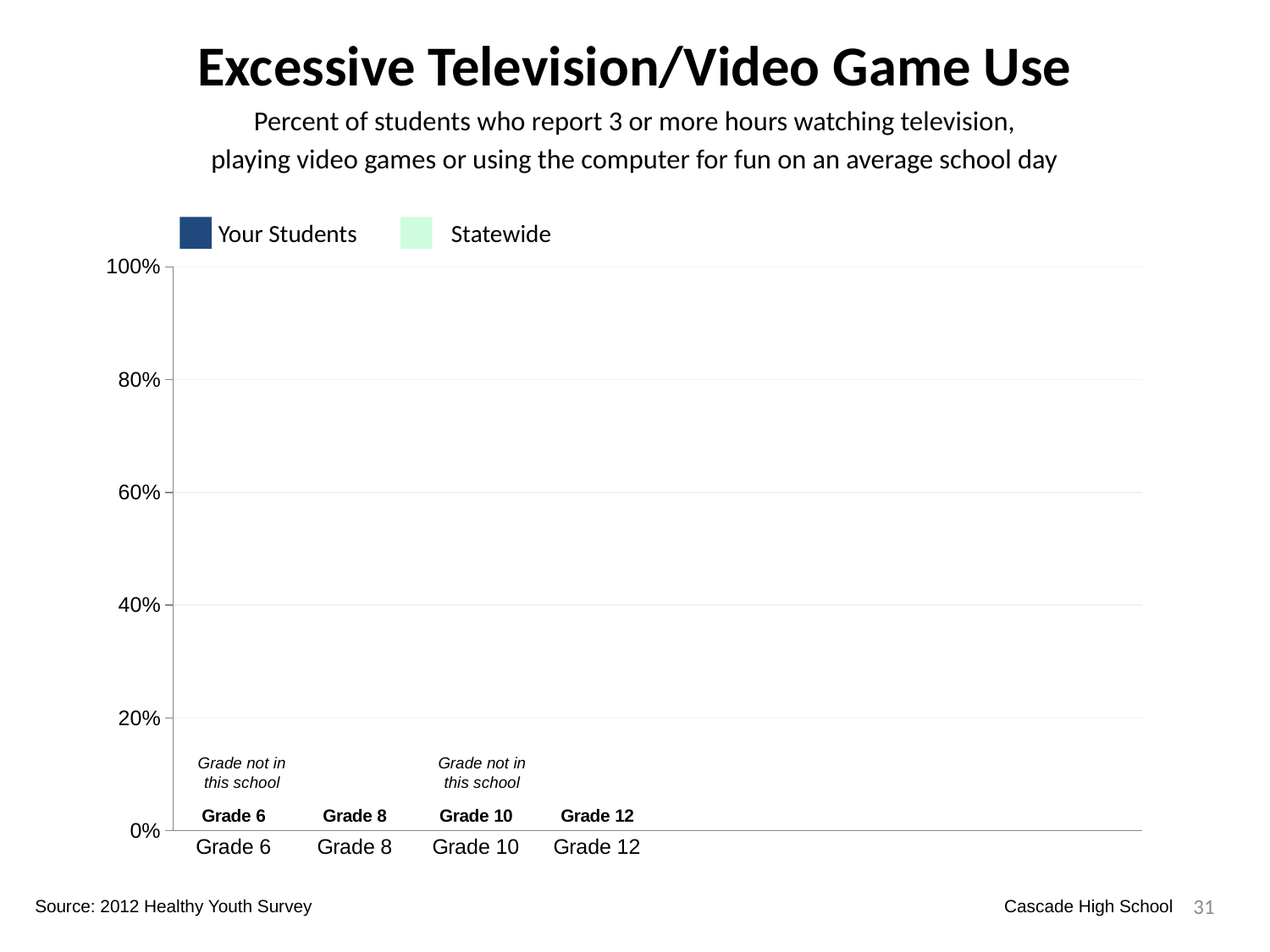
What are the two series named in the legend? Your Students and Statewide Which grades are marked as 'Grade not in this school'? Grade 6 and Grade 10 Which school is the chart for? Cascade High School How many series does the legend list? 2 What is the title of the chart? Excessive Television/Video Game Use What is the highest value shown on the y axis? 100% What is the source cited for the chart? 2012 Healthy Youth Survey How many grade categories are shown on the x axis? 4